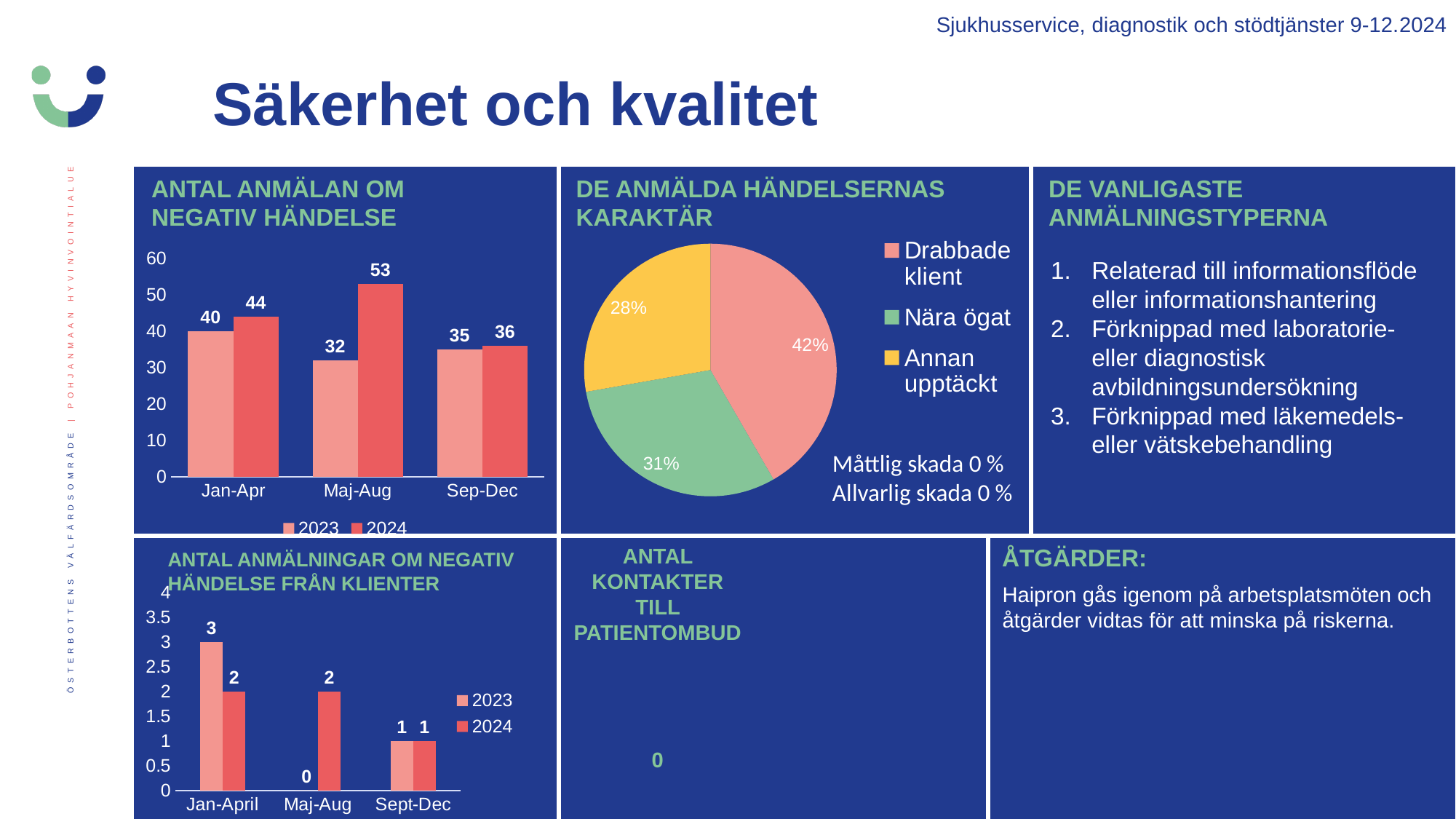
In the chart 'ANTAL ANMÄLAN OM NEGATIV HÄNDELSE', what is the difference between the 2024 and 2023 values in Maj-Aug? 21 In the pie chart 'DE ANMÄLDA HÄNDELSERNAS KARAKTÄR', what share is 'Nära ögat'? 31% In the pie chart 'DE ANMÄLDA HÄNDELSERNAS KARAKTÄR', how many slices are there? 3 In the chart 'ANTAL ANMÄLNINGAR OM NEGATIV HÄNDELSE FRÅN KLIENTER', which is larger in Jan-April, 2023 or 2024? 2023 What kind of chart is 'ANTAL ANMÄLAN OM NEGATIV HÄNDELSE'? bar chart In the chart 'ANTAL ANMÄLAN OM NEGATIV HÄNDELSE', which period has the highest 2024 value? Maj-Aug In the chart 'ANTAL ANMÄLAN OM NEGATIV HÄNDELSE', which period has the lowest 2023 value? Maj-Aug In the chart 'ANTAL ANMÄLAN OM NEGATIV HÄNDELSE', what is the value for 2023 in Sep-Dec? 35 In the chart 'ANTAL ANMÄLNINGAR OM NEGATIV HÄNDELSE FRÅN KLIENTER', what is the value for 2023 in Maj-Aug? 0 In the chart 'ANTAL ANMÄLAN OM NEGATIV HÄNDELSE', how many series does the legend list? 2 In the chart 'ANTAL ANMÄLAN OM NEGATIV HÄNDELSE', what is the value for 2024 in Maj-Aug? 53 In the pie chart 'DE ANMÄLDA HÄNDELSERNAS KARAKTÄR', which category has the largest share? Drabbade klient